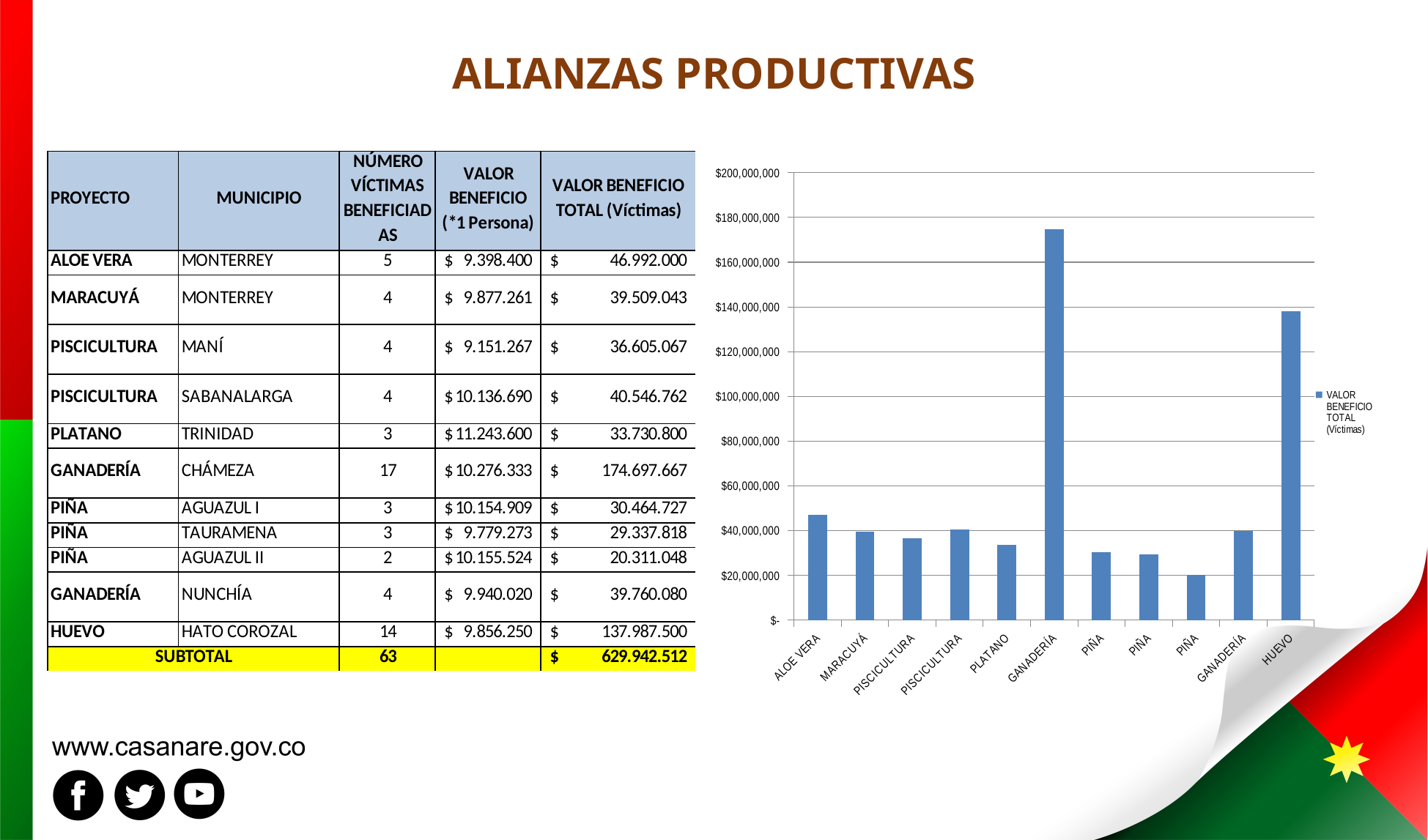
What is the highest value shown on the chart's vertical axis? $200,000,000 Is the value for HUEVO greater or less than $120,000,000? greater Is the value for ALOE VERA greater or less than $40,000,000? greater Which is larger, the value for ALOE VERA or the value for PLATANO? ALOE VERA Is the value for PLATANO greater or less than $40,000,000? less Which category has the tallest bar in the chart? GANADERÍA How many bars are plotted in the chart? 11 How many series does the chart legend list? 1 What kind of chart is shown on the slide? bar chart Which category has the shortest bar in the chart? PIÑA What is the name of the series shown in the chart legend? VALOR BENEFICIO TOTAL (Víctimas)